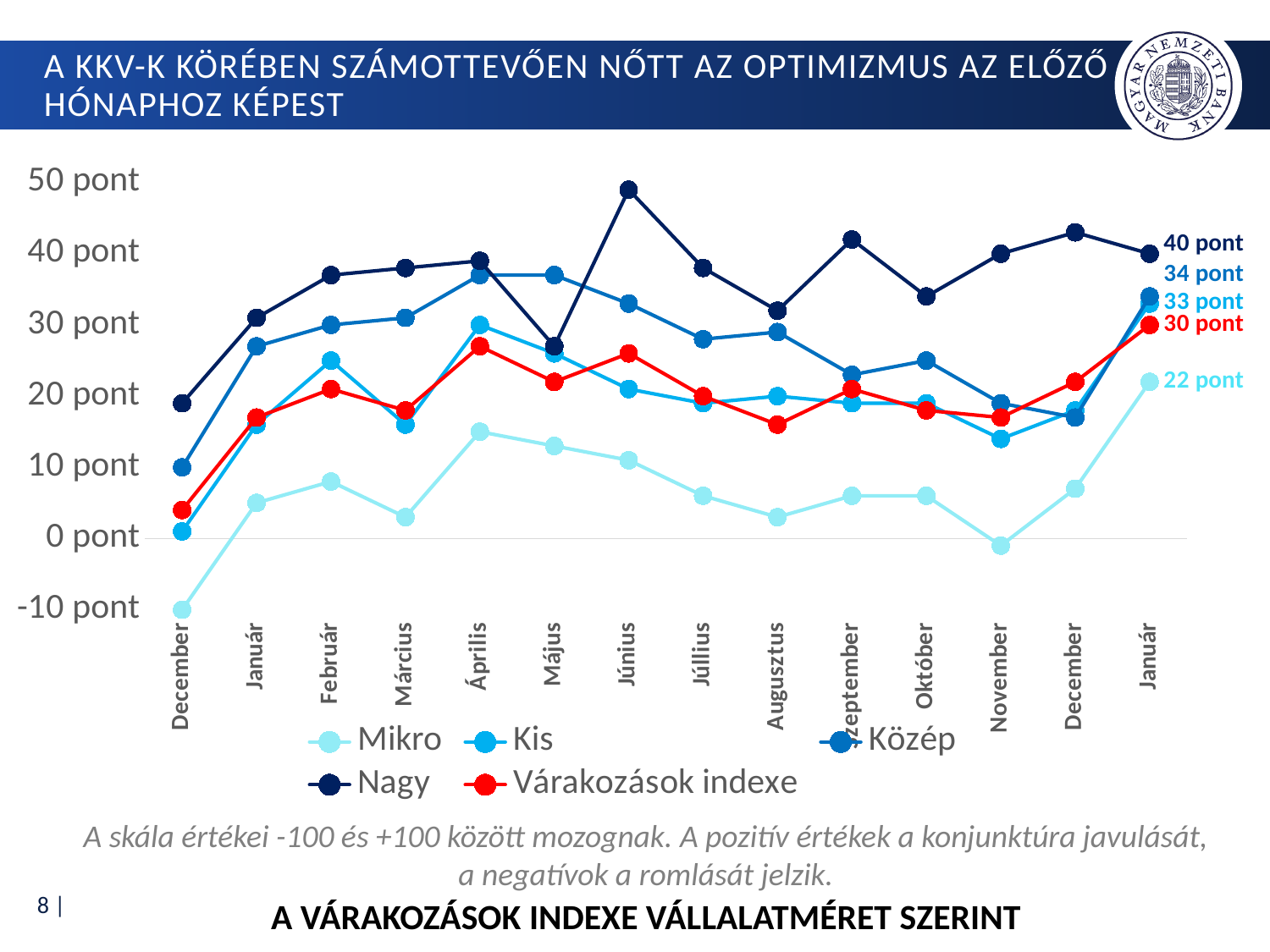
What is the title of the chart shown at the bottom of the slide? A VÁRAKOZÁSOK INDEXE VÁLLALATMÉRET SZERINT How many series does the legend list? 5 What is the difference between the Nagy and Mikro values at the final Január point? 18 pont Is the value of the Nagy series in Június greater or less than 40 pont? greater Which series has the highest value at the final Január point? Nagy At the final Január point, which is larger: Közép or Kis? Közép How many months are shown along the x axis? 14 Which series has the lowest value at the final Január point? Mikro What is the value of the Várakozások indexe series at the final Január point? 30 pont What kind of chart is shown on the slide? line chart What is the value of the Nagy series at the final Január point? 40 pont What is the value of the Mikro series at the final Január point? 22 pont